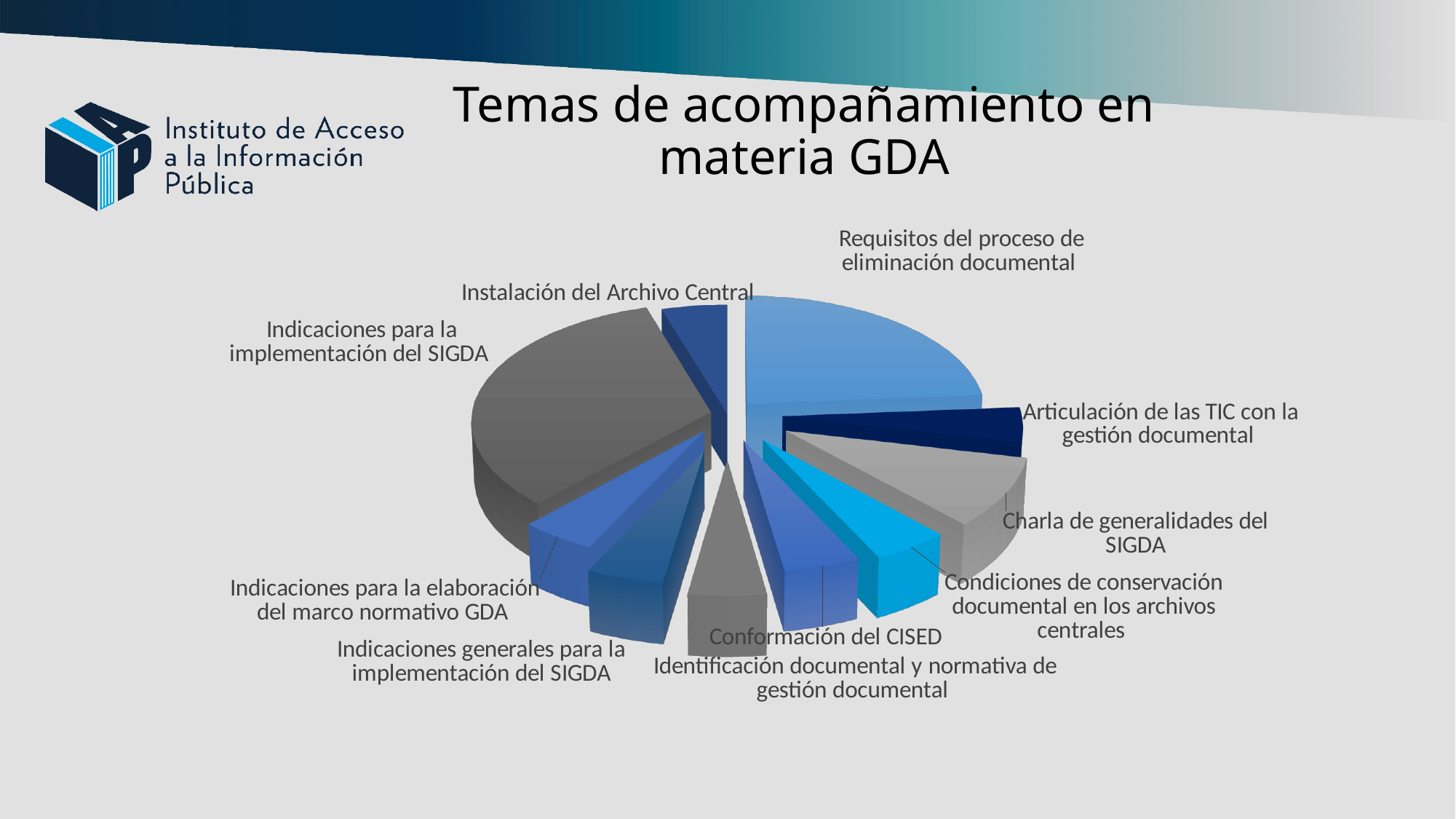
Which slice is larger: 'Requisitos del proceso de eliminación documental' or 'Conformación del CISED'? Requisitos del proceso de eliminación documental Does the pie chart display numeric data labels on its slices? No What is the title of the chart on the slide? Temas de acompañamiento en materia GDA Which slice is larger: 'Indicaciones para la implementación del SIGDA' or 'Instalación del Archivo Central'? Indicaciones para la implementación del SIGDA What kind of chart is shown on the slide? Pie chart How many categories (slices) does the pie chart have? 10 Which slice is larger: 'Requisitos del proceso de eliminación documental' or 'Articulación de las TIC con la gestión documental'? Requisitos del proceso de eliminación documental